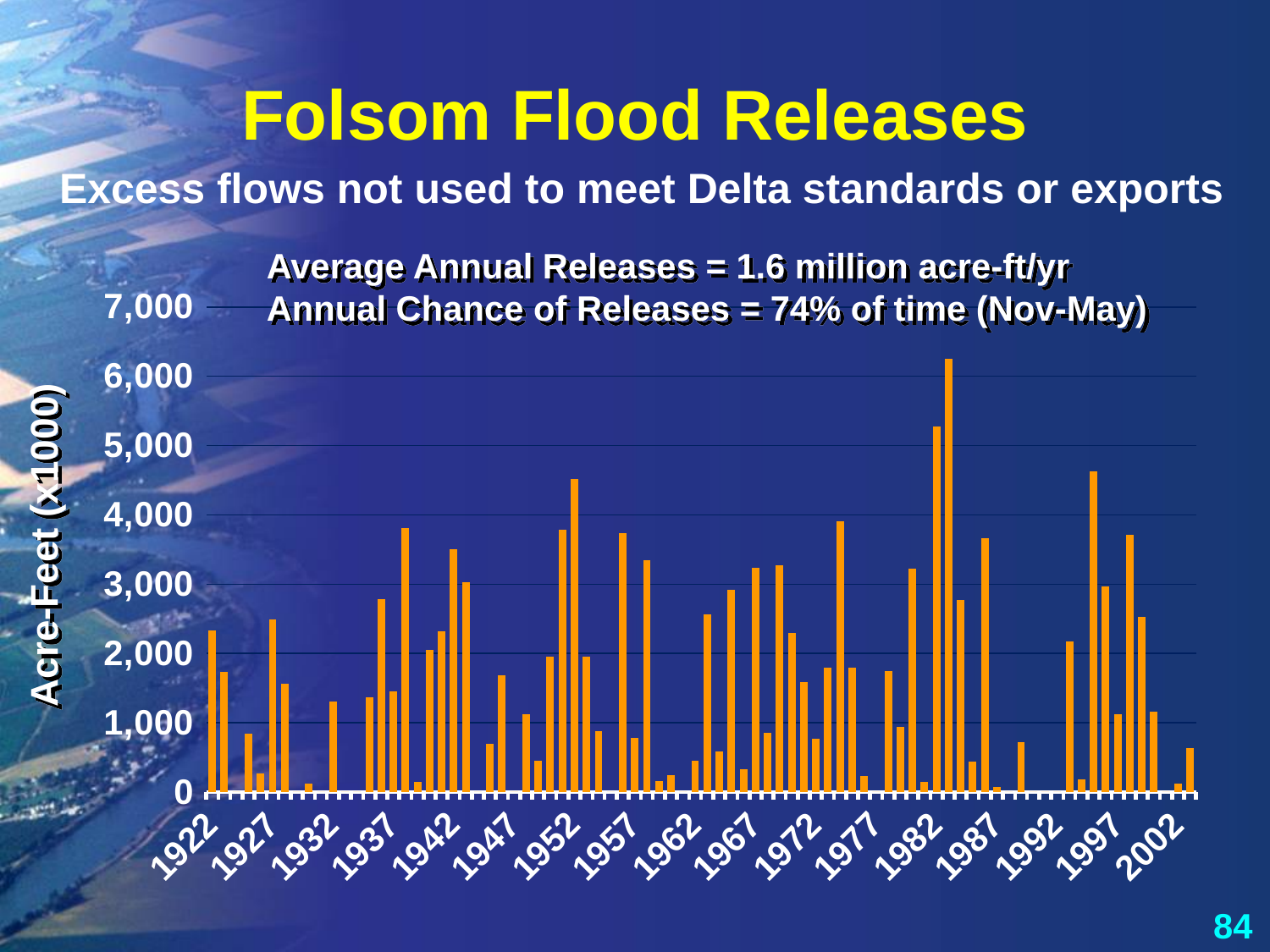
Is the tallest bar in the chart greater or less than 7,000? less Is the tallest bar near the 1952 label greater or less than 4,000? greater Which is taller: the tallest bar between the 1982 and 1987 labels, or the tallest bar between the 1952 and 1957 labels? the tallest bar between 1982 and 1987 Is the tallest bar in the chart greater or less than 6,000? greater What is the title of the chart on the slide? Folsom Flood Releases What kind of chart is shown on the slide? bar chart Between which two labeled years on the x axis does the tallest bar fall? 1982 and 1987 What is the label on the vertical axis of the chart? Acre-Feet (x1000)